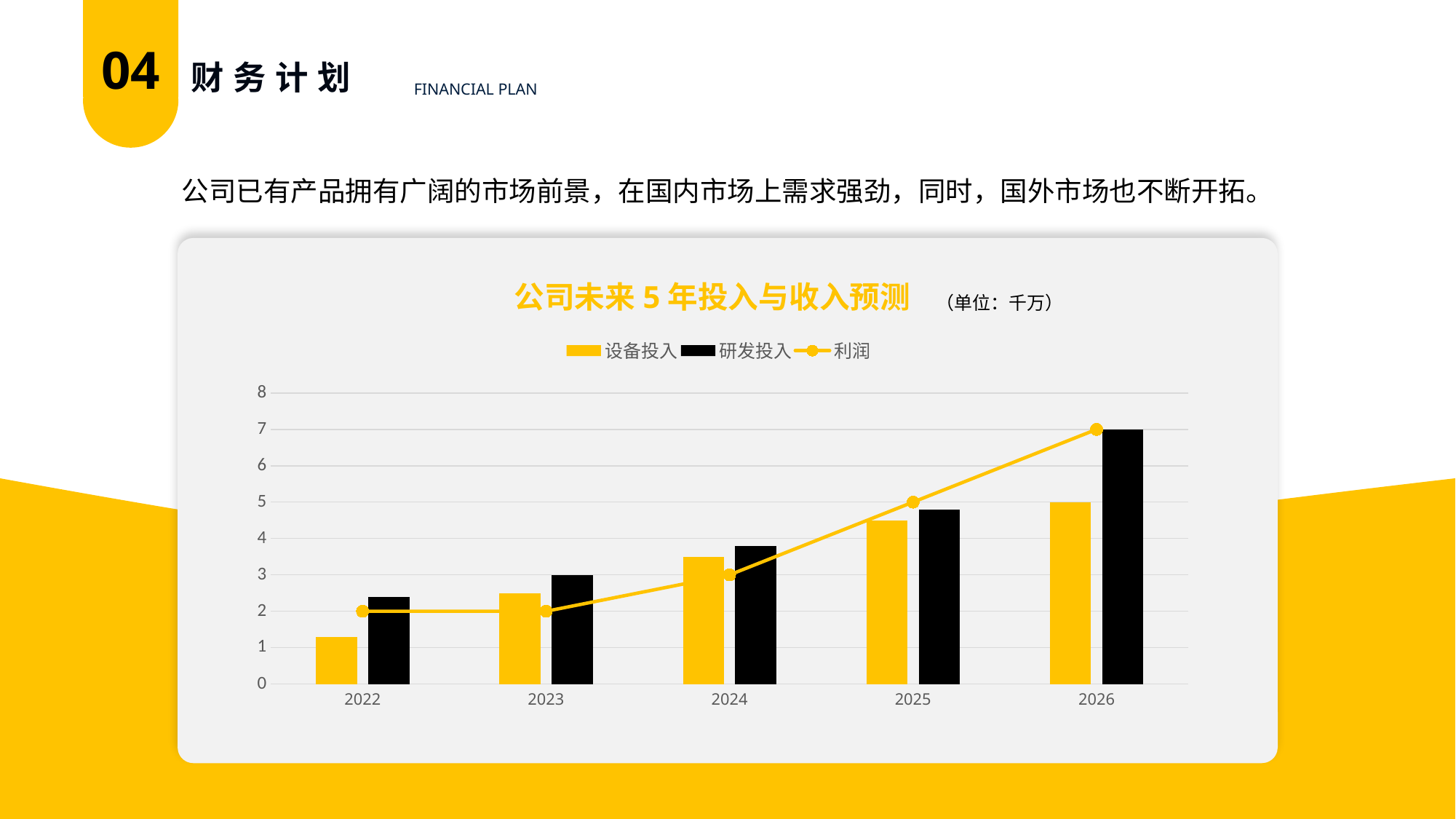
In 2022, which is larger: 设备投入 or 研发投入? 研发投入 Is the value for 设备投入 in 2022 greater or less than 2? less How many years are shown on the x axis? 5 What kind of chart is shown on the slide? A combined bar and line chart In which year is 设备投入 the lowest? 2022 What is the value of 研发投入 in 2023? 3 How many series does the legend list? 3 What is the value of 利润 in 2024? 3 Is the value for 研发投入 in 2025 greater or less than 4? greater In which year is 研发投入 the highest? 2026 What is the value of 利润 in 2026? 7 What is the difference between 利润 in 2026 and 利润 in 2022? 5